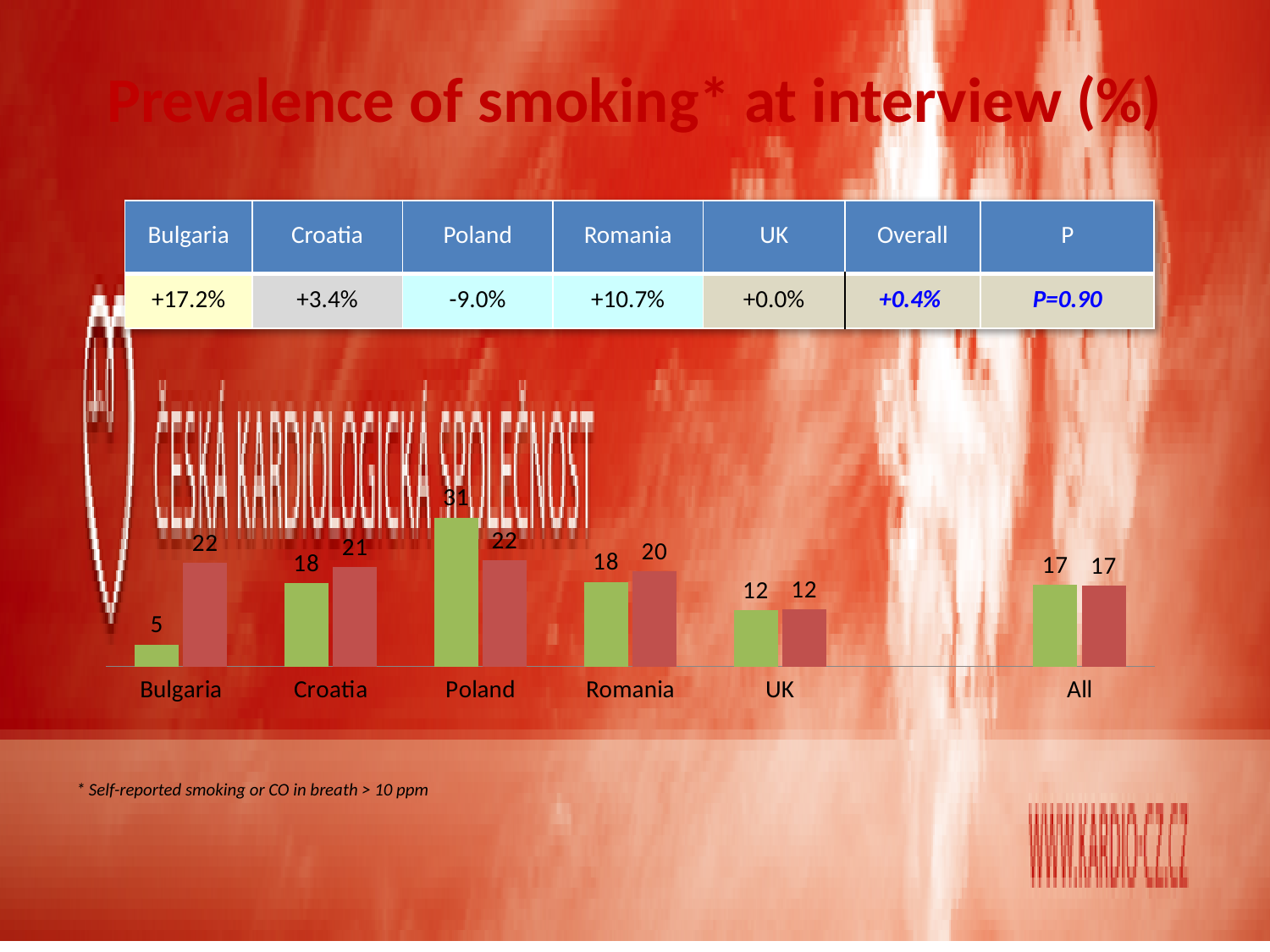
What is the difference between the red bar and the green bar for Bulgaria? 17 What is the title of the slide containing the chart? Prevalence of smoking* at interview (%) Which category has the lowest green bar? Bulgaria Which category has the highest green bar? Poland For Romania, which is larger, the green bar or the red bar? the red bar What are the values of the two bars for UK? 12 and 12 What is the value of the green bar for Bulgaria? 5 What is the value of the green bar for Poland? 31 What kind of chart is shown on the slide? bar chart What is the difference between the green bars for Poland and Croatia? 13 What is the value of the red bar for Poland? 22 How many categories are shown on the x axis of the chart? 6